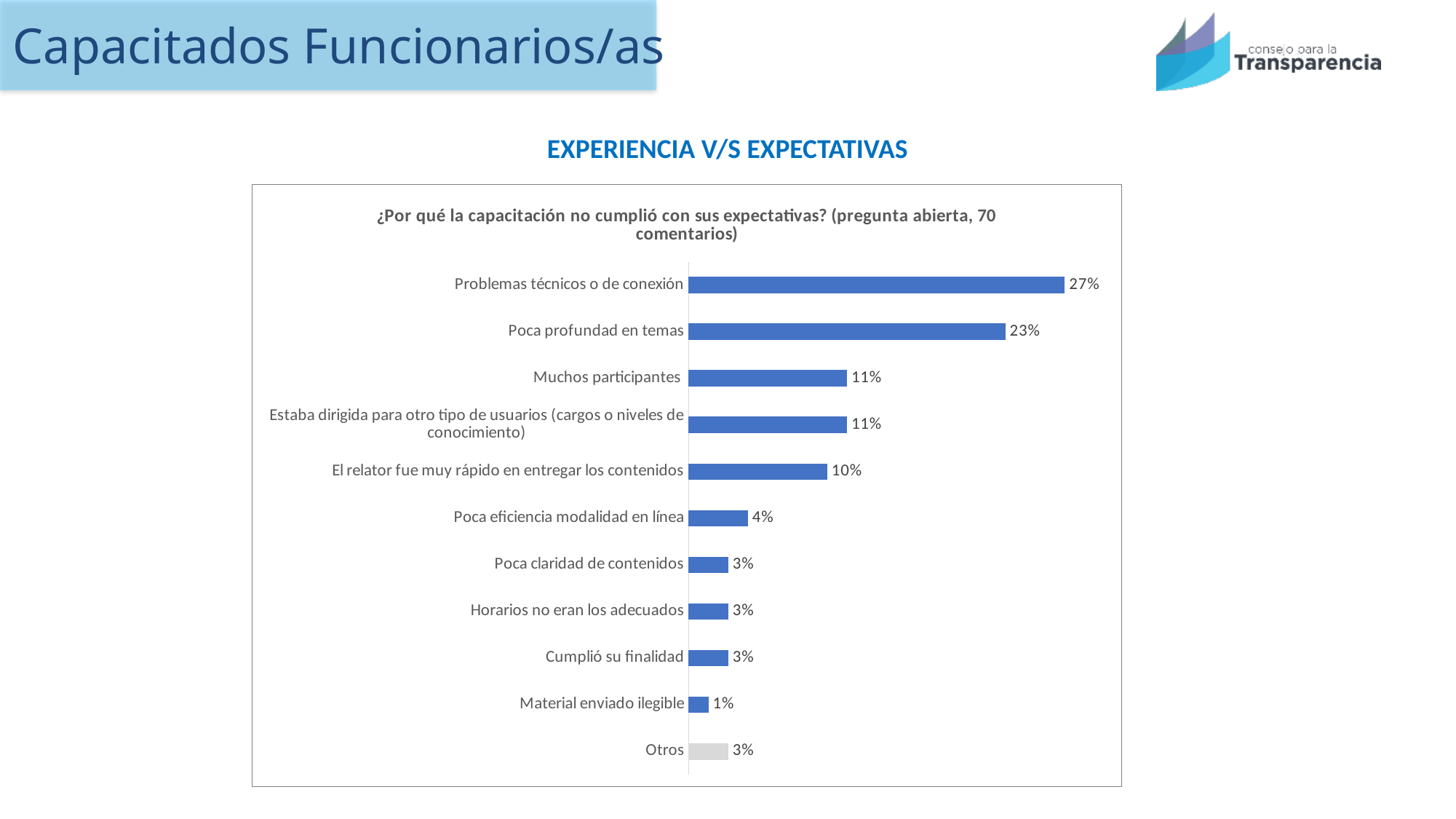
What is the value for "El relator fue muy rápido en entregar los contenidos"? 10% According to the chart title, how many comments were collected for the open question? 70 What is the value for "Material enviado ilegible"? 1% Which category has the lowest value? Material enviado ilegible How many categories are shown in the chart? 11 What is the value for "Poca eficiencia modalidad en línea"? 4% What is the value for "Problemas técnicos o de conexión"? 27% What is the value for "Poca profundad en temas"? 23% Which category has the highest value? Problemas técnicos o de conexión What kind of chart is shown on the slide? Bar chart What is the difference between the values for "Problemas técnicos o de conexión" and "Poca profundad en temas"? 4% Which is larger, the value for "Muchos participantes" or the value for "El relator fue muy rápido en entregar los contenidos"? Muchos participantes